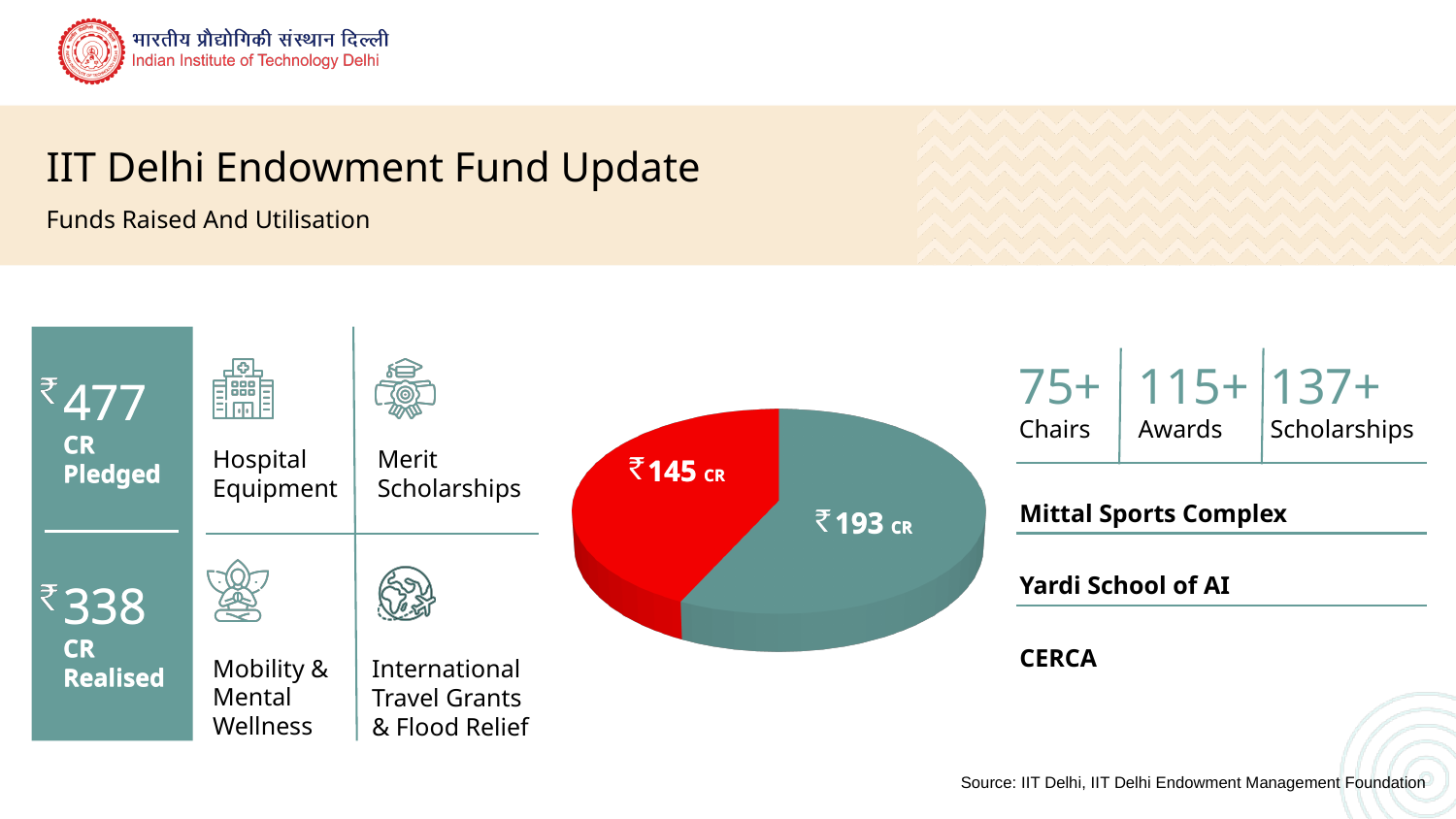
What colour is the slice labelled ₹193 CR in the pie chart? Teal What kind of chart is shown in the centre of the slide? Pie chart What is the difference between the two values in the pie chart? ₹48 CR What is the smallest value shown in the pie chart? ₹145 CR What is the total of the two values shown in the pie chart? ₹338 CR Which slice of the pie chart is larger, the red one or the teal one? The teal one What value is labelled on the red slice of the pie chart? ₹145 CR Does the pie chart have a legend? No Is the value of the red slice in the pie chart greater or less than 150? less What is the largest value shown in the pie chart? ₹193 CR What value is labelled on the teal slice of the pie chart? ₹193 CR How many slices does the pie chart have? 2